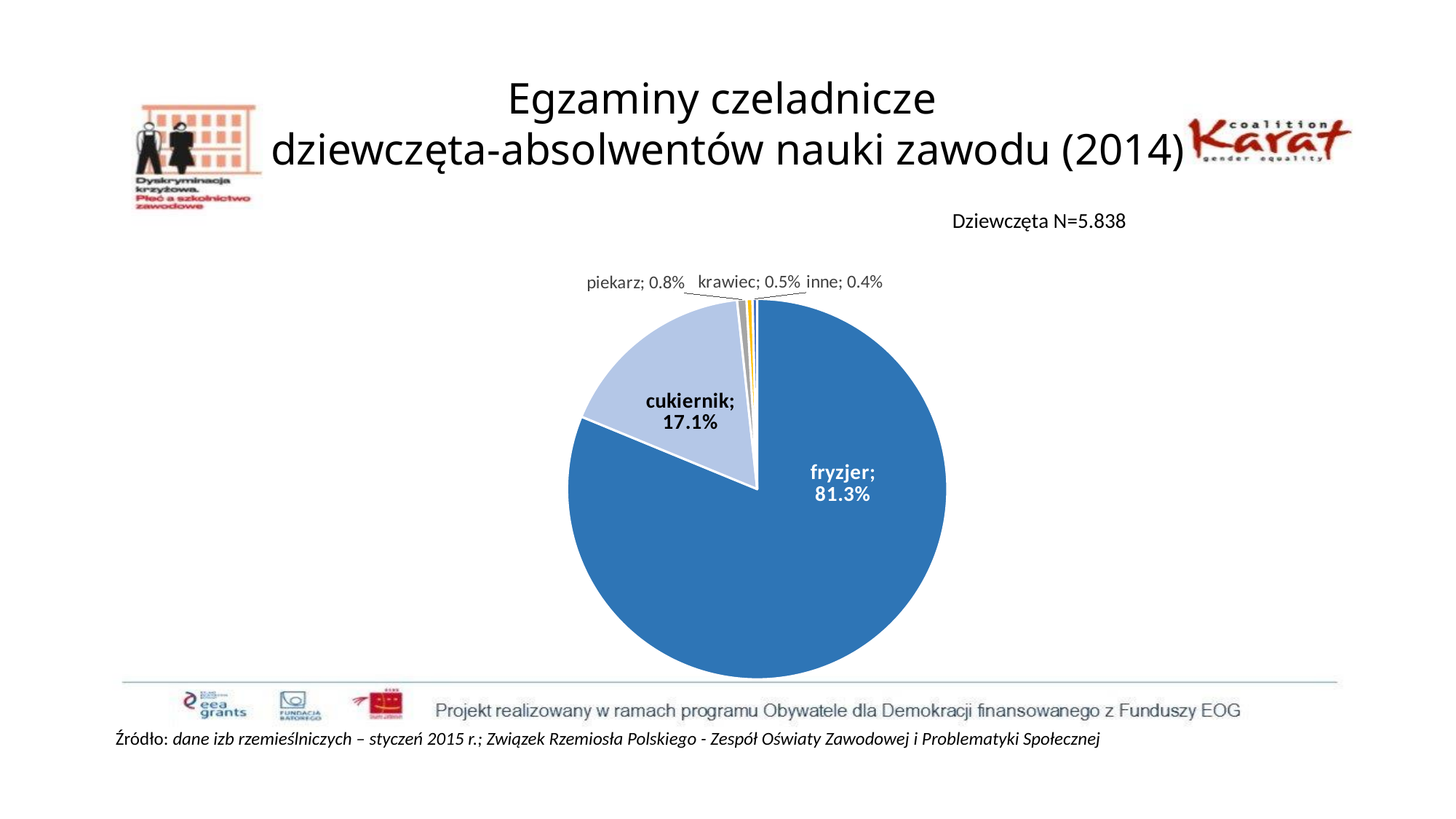
What is the value for piekarz? 0.8% What is the value for krawiec? 0.5% What kind of chart is shown on the slide? pie chart What share of the pie does cukiernik have? 17.1% Which category has the largest share of the pie? fryzjer What is the difference between the shares of fryzjer and cukiernik? 64.2% What is the sample size (N) for girls stated on the slide? N=5.838 What share of the pie does fryzjer have? 81.3% What is the value for inne? 0.4% How many categories are shown in the pie chart? 5 Which category has the smallest share of the pie? inne Which is larger, the share for piekarz or the share for krawiec? piekarz